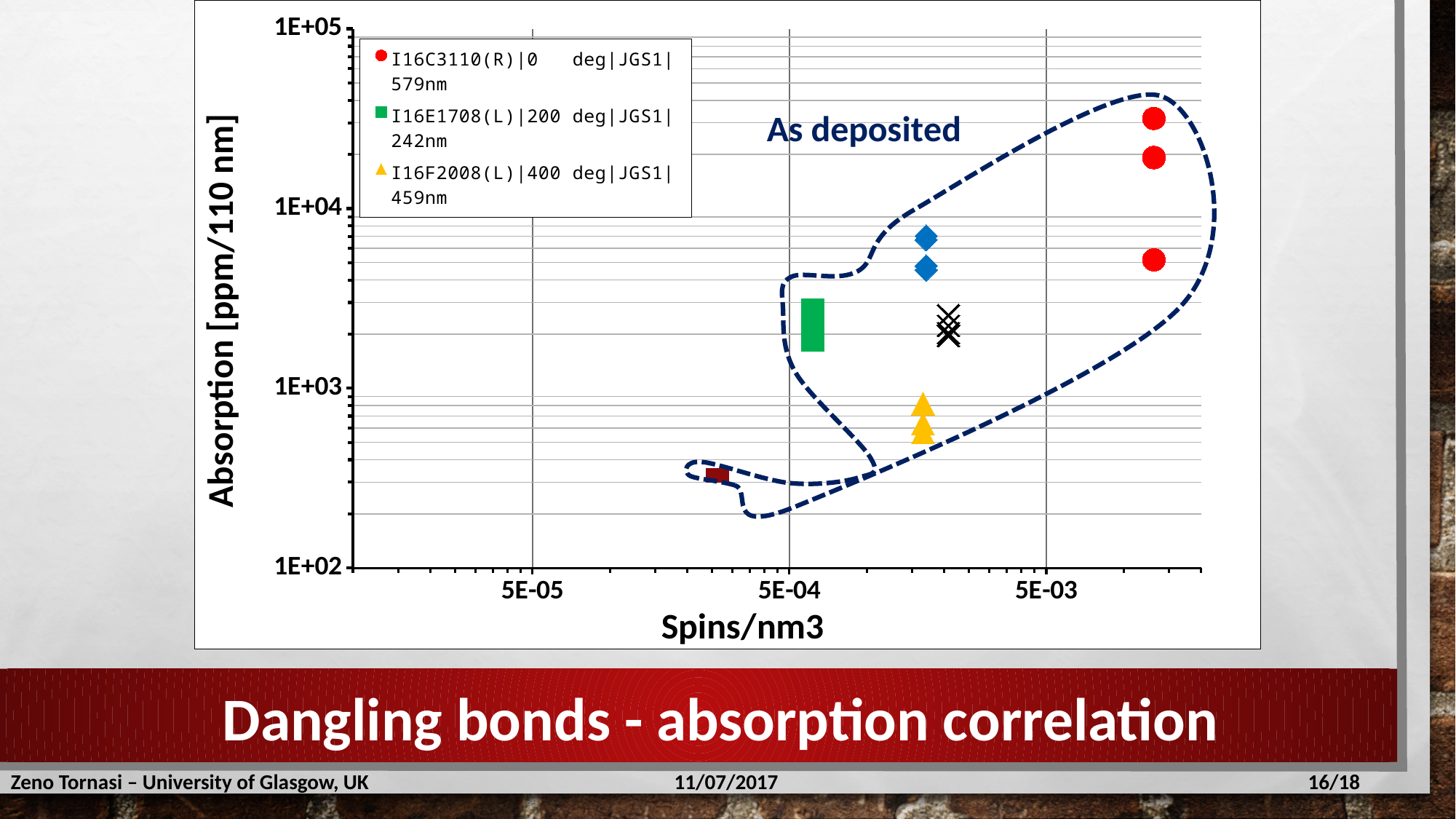
What is the title of the vertical axis? Absorption [ppm/110 nm] How many series does the legend list? 3 Which of the legend series has the highest absorption values? I16C3110(R)|0 deg|JGS1|579nm Which series has higher Spins/nm3 values, I16E1708(L)|200 deg|JGS1|242nm or I16C3110(R)|0 deg|JGS1|579nm? I16C3110(R)|0 deg|JGS1|579nm Is the absorption value for the I16E1708(L)|200 deg|JGS1|242nm series greater or less than 1E+03? greater Is the highest absorption value for the I16C3110(R)|0 deg|JGS1|579nm series greater or less than 1E+04? greater Are the absorption values for the I16F2008(L)|400 deg|JGS1|459nm series greater or less than 1E+03? less Overall, does absorption rise or fall as Spins/nm3 increases along the x axis? rise What kind of chart is shown on the slide? scatter chart What text label is written inside the dashed outline on the chart? As deposited Which of the legend series has the lowest absorption values? I16F2008(L)|400 deg|JGS1|459nm